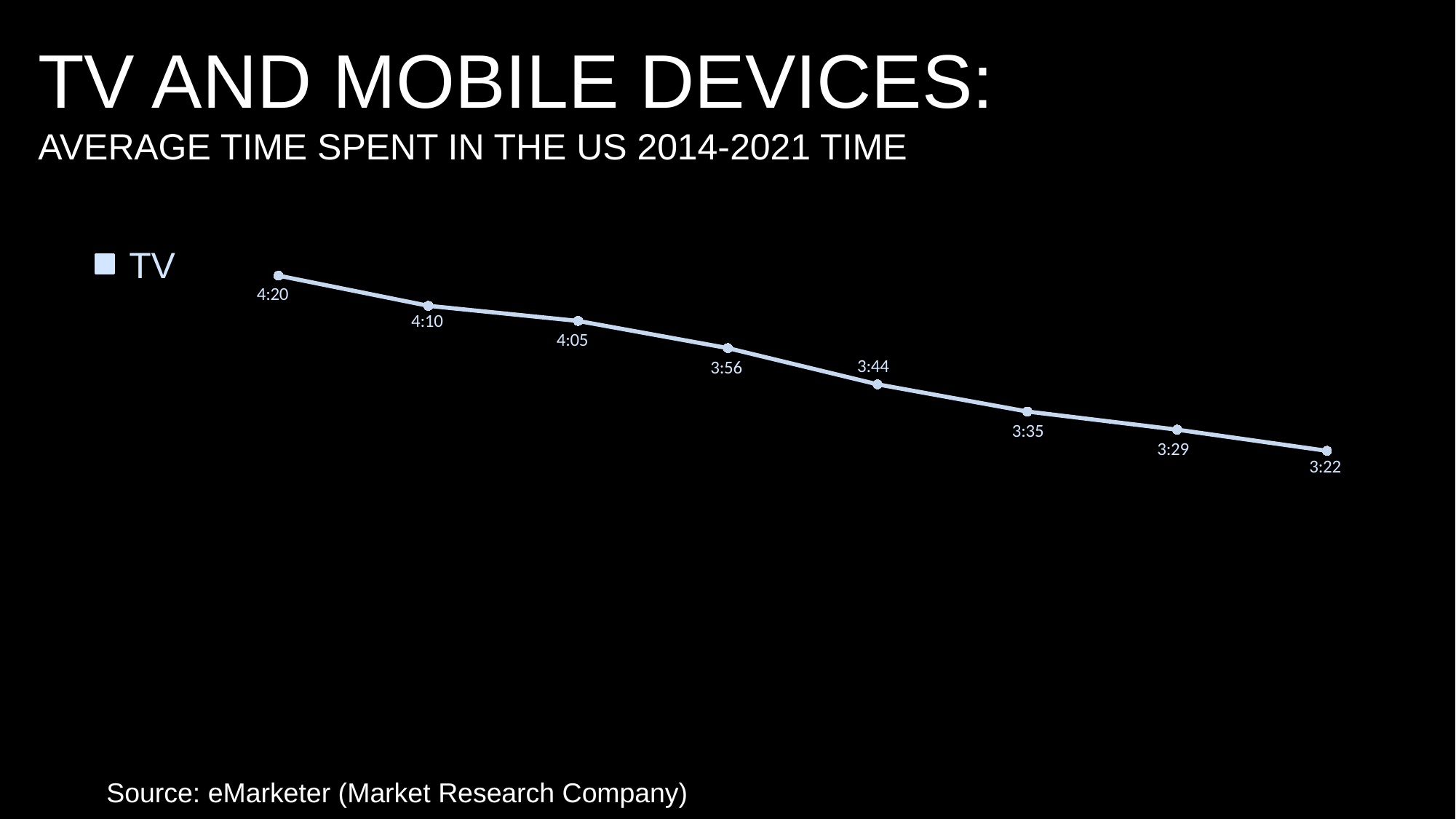
What is the difference between the first point (4:20) and the last point (3:22) on the TV line? 58 minutes Do the values on the TV line rise or fall from left to right? fall Which point on the TV line has the highest value? the first point, 4:20 What is the value of the fourth point from the left on the TV line? 3:56 What series name is shown in the chart legend? TV What is the value of the last (rightmost) point on the TV line? 3:22 What kind of chart is shown on the slide? line chart Which point on the TV line has the lowest value? the last point, 3:22 How many series does the legend list? 1 How many data points are plotted on the TV line? 8 What is the value of the first (leftmost) point on the TV line? 4:20 Which is larger, the fourth point (3:56) or the fifth point (3:44) on the TV line? 3:56